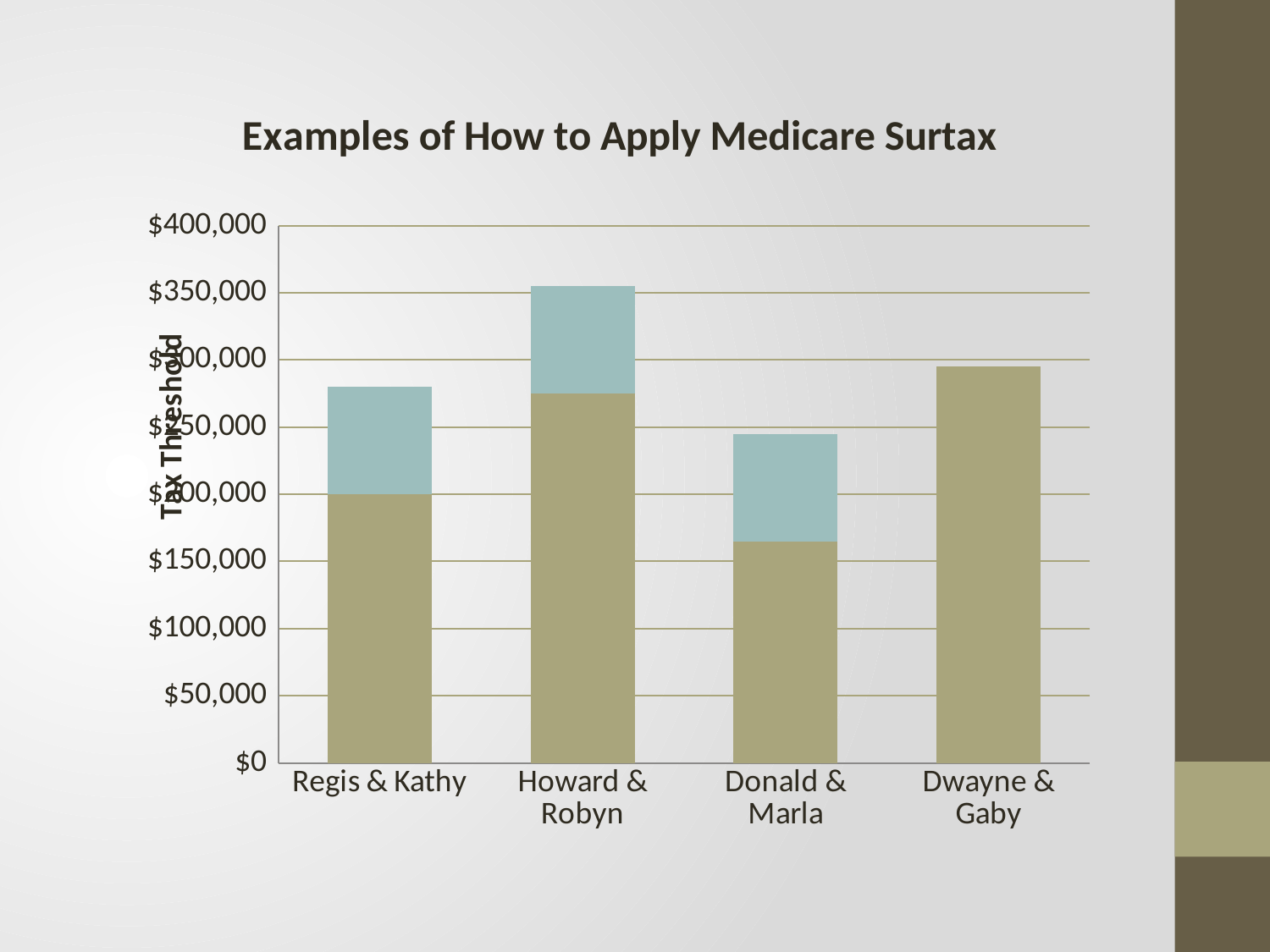
What is the label on the vertical axis? Tax Threshold Is the total bar height for Regis & Kathy greater or less than $300,000? less How many couples (categories) are shown on the x axis? 4 Is the bar for Dwayne & Gaby greater or less than $250,000? greater Is the total bar height for Donald & Marla greater or less than $300,000? less Which couple has the tallest bar overall? Howard & Robyn Which couple has the shortest bar overall? Donald & Marla What is the title of the chart? Examples of How to Apply Medicare Surtax What kind of chart is shown on the slide? bar chart Which bar is taller overall, Howard & Robyn or Donald & Marla? Howard & Robyn